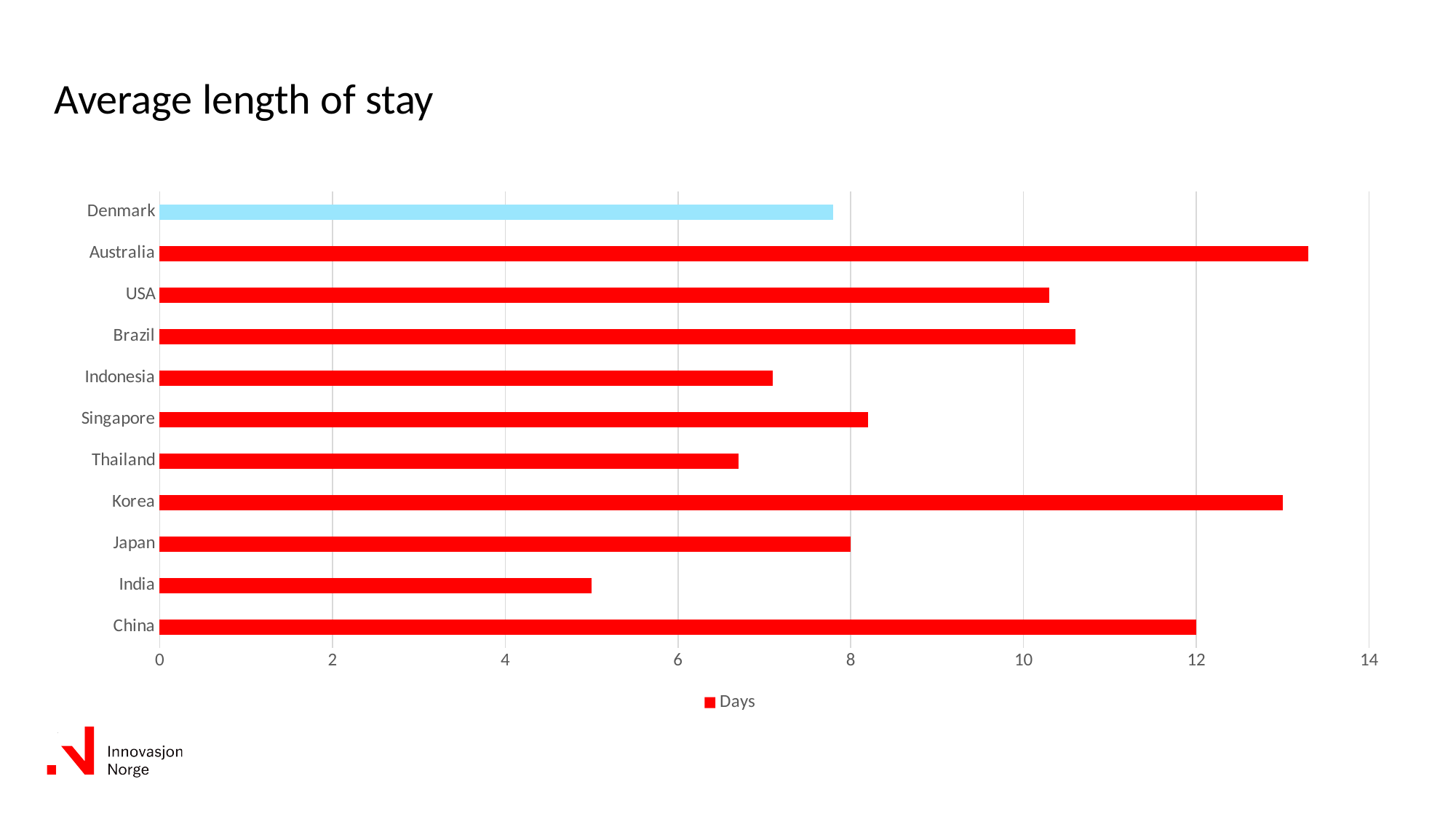
How many series does the legend list? 1 Which has a longer average length of stay, Indonesia or Thailand? Indonesia What type of chart is shown on the slide? bar chart Which country has the lowest average length of stay? India Is the value for Thailand greater or less than 8? less What is the title of the chart? Average length of stay Which country has the highest average length of stay? Australia Is the value for USA greater or less than 10? greater Which has a longer average length of stay, Korea or China? Korea Is the value for Korea greater or less than 12? greater How many countries are shown in the chart? 11 What is the average length of stay for China in days? 12